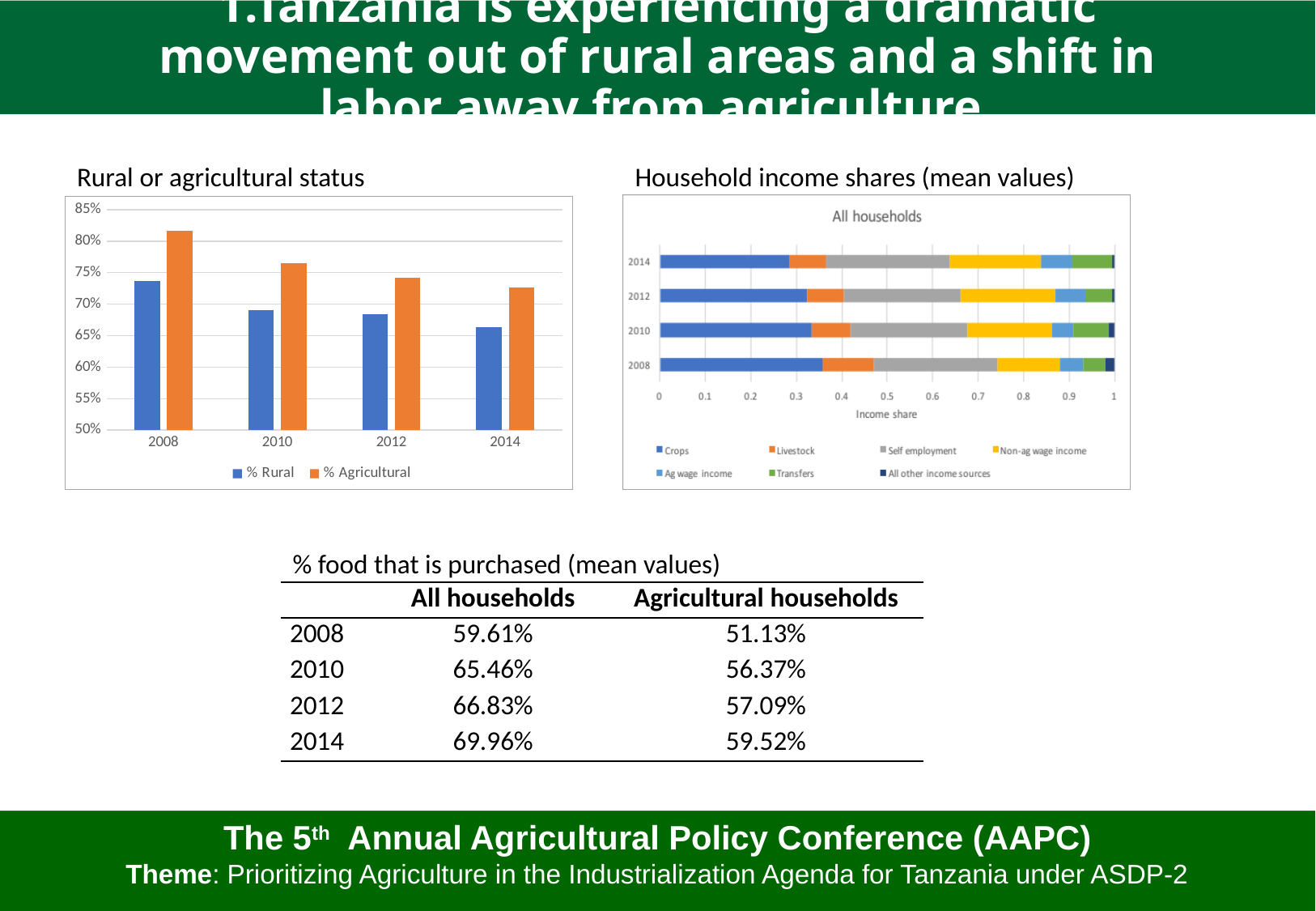
How many series does the legend of the 'Rural or agricultural status' chart list? 2 What kind of chart is the 'Rural or agricultural status' chart? bar chart In the 'Household income shares (mean values)' chart, is the Crops share for 2008 greater or less than 0.3? greater In the 'Rural or agricultural status' chart, which year has the highest % Agricultural value? 2008 In the 'Rural or agricultural status' chart, is the % Rural value for 2014 greater or less than 70%? less In the 'Rural or agricultural status' chart, which is larger for 2008: % Rural or % Agricultural? % Agricultural What is the x-axis label of the 'Household income shares (mean values)' chart? Income share How many income sources does the legend of the 'Household income shares (mean values)' chart list? 7 In the 'Rural or agricultural status' chart, is the % Agricultural value for 2008 greater or less than 80%? greater In the 'Rural or agricultural status' chart, does the % Rural series rise or fall from 2008 to 2014? fall How many years are shown on the x axis of the 'Rural or agricultural status' chart? 4 In the 'Rural or agricultural status' chart, which year has the lowest % Rural value? 2014